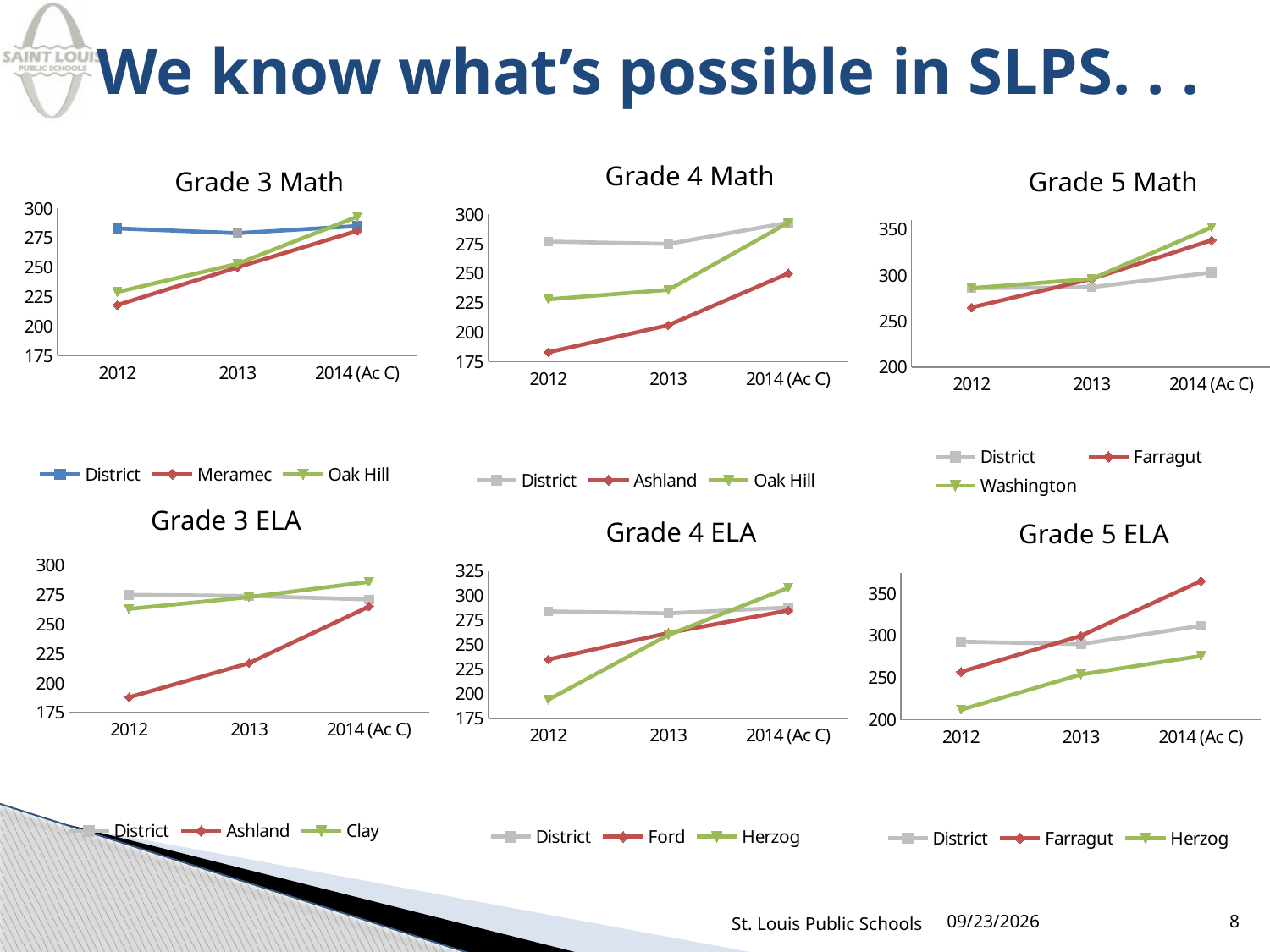
In the Grade 5 ELA chart, which series has the lowest value in 2012? Herzog In the Grade 5 Math chart, which series has the highest value in 2014 (Ac C)? Washington In the Grade 4 Math chart, is the value for Ashland in 2012 greater or less than 200? less Which three series are listed in the legend of the Grade 3 ELA chart? District, Ashland, Clay In the Grade 4 Math chart, which series has the lowest value in 2012? Ashland How many series does the legend of the Grade 5 Math chart list? 3 In the Grade 3 ELA chart, is the value for Clay in 2014 (Ac C) greater or less than 275? greater In the Grade 4 ELA chart, is the value for Herzog in 2014 (Ac C) greater or less than 300? greater What kind of chart is the Grade 3 Math chart? line chart In the Grade 5 ELA chart, which is larger in 2014 (Ac C): Farragut or Herzog? Farragut How many points are plotted along the x axis of the Grade 4 ELA chart? 3 In the Grade 3 Math chart, does the Meramec line rise or fall from 2012 to 2014 (Ac C)? rise